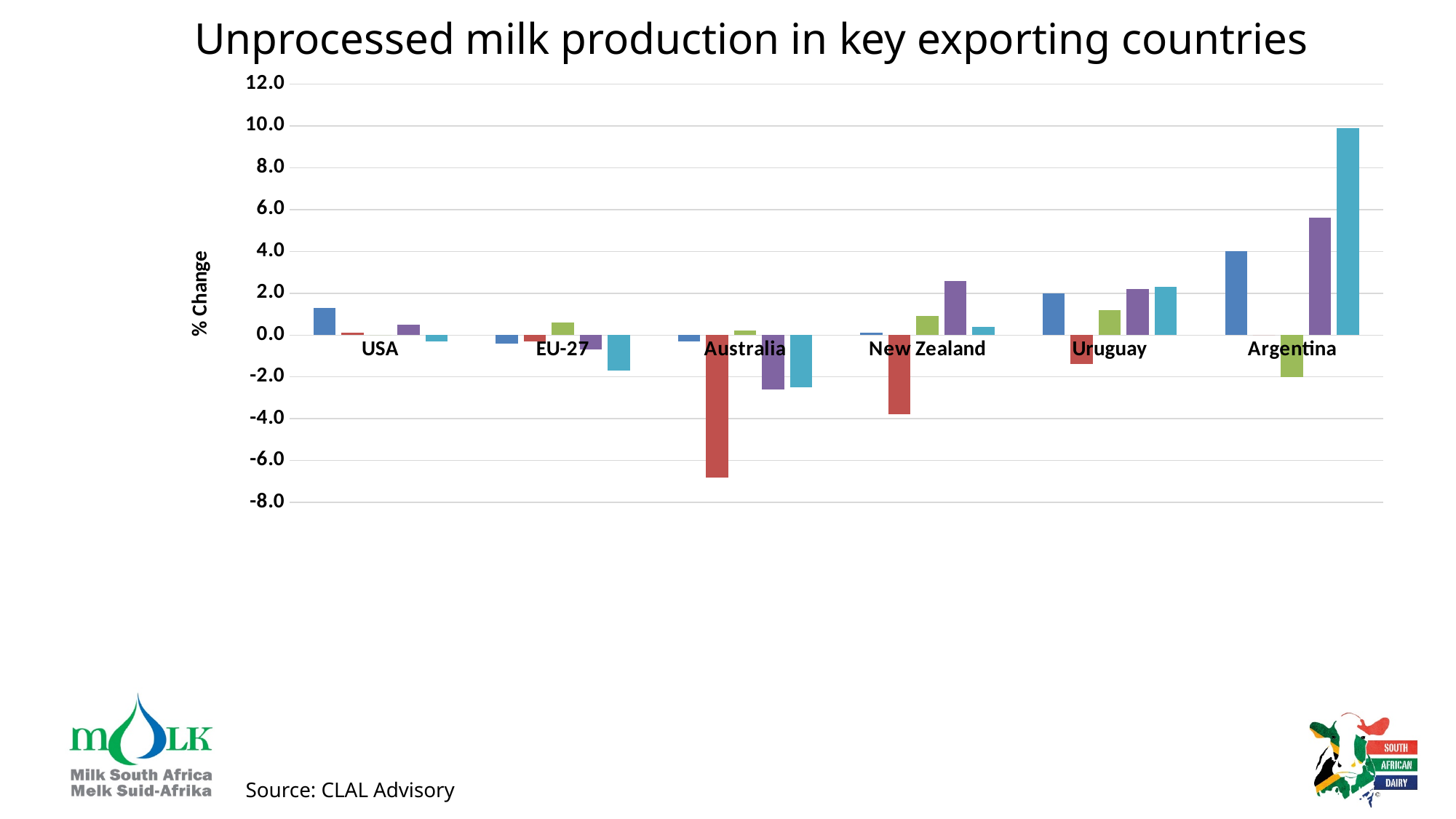
What is the title of the chart? Unprocessed milk production in key exporting countries Is the value of the purple bar for Argentina greater or less than 4.0? greater Is the value of the red bar for Australia greater or less than -6.0? less How many countries are shown on the x axis of the chart? 6 Which is larger, the blue bar for Argentina or the blue bar for USA? Argentina Is the value of the teal bar for Argentina greater or less than 8.0? greater What is the label on the vertical axis of the chart? % Change What kind of chart is shown on the slide? bar chart Which country has the lowest (most negative) bar in the chart? Australia Which country has the tallest bar in the chart? Argentina